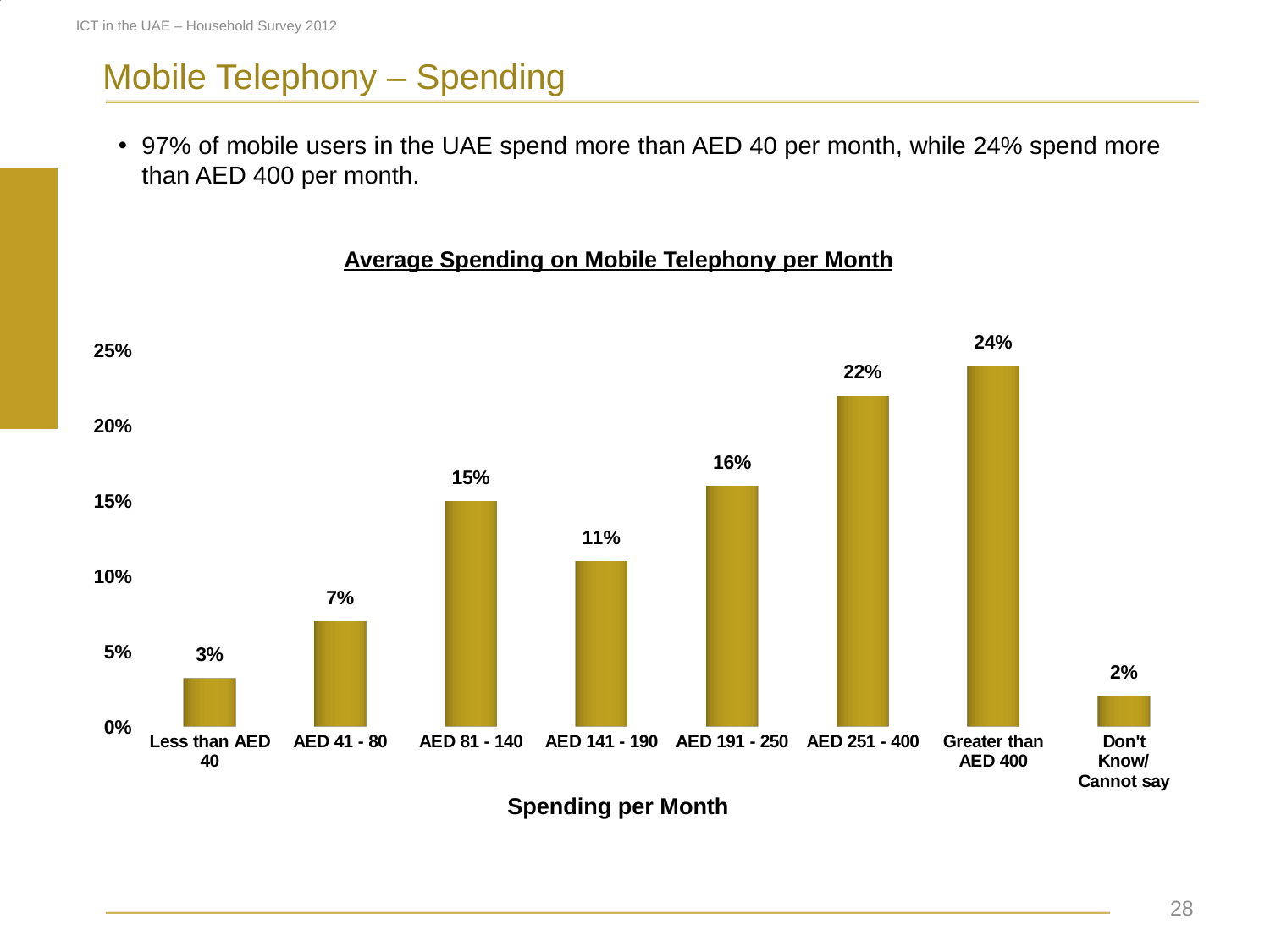
What is the title of the chart? Average Spending on Mobile Telephony per Month How many spending categories are shown on the x axis? 8 What percentage of mobile users spend AED 81 - 140 per month? 15% What is the difference between the 'AED 251 - 400' and 'AED 141 - 190' values? 11% What is the value for the 'Greater than AED 400' category? 24% Is the value for 'AED 41 - 80' greater or less than 10%? less What kind of chart is shown on the slide? bar chart Which spending category has the lowest percentage? Don't Know/ Cannot say What is the label of the x axis? Spending per Month What percentage of respondents answered 'Don't Know/ Cannot say'? 2% Which is larger: the value for 'AED 191 - 250' or the value for 'AED 81 - 140'? AED 191 - 250 Which spending category has the highest percentage? Greater than AED 400